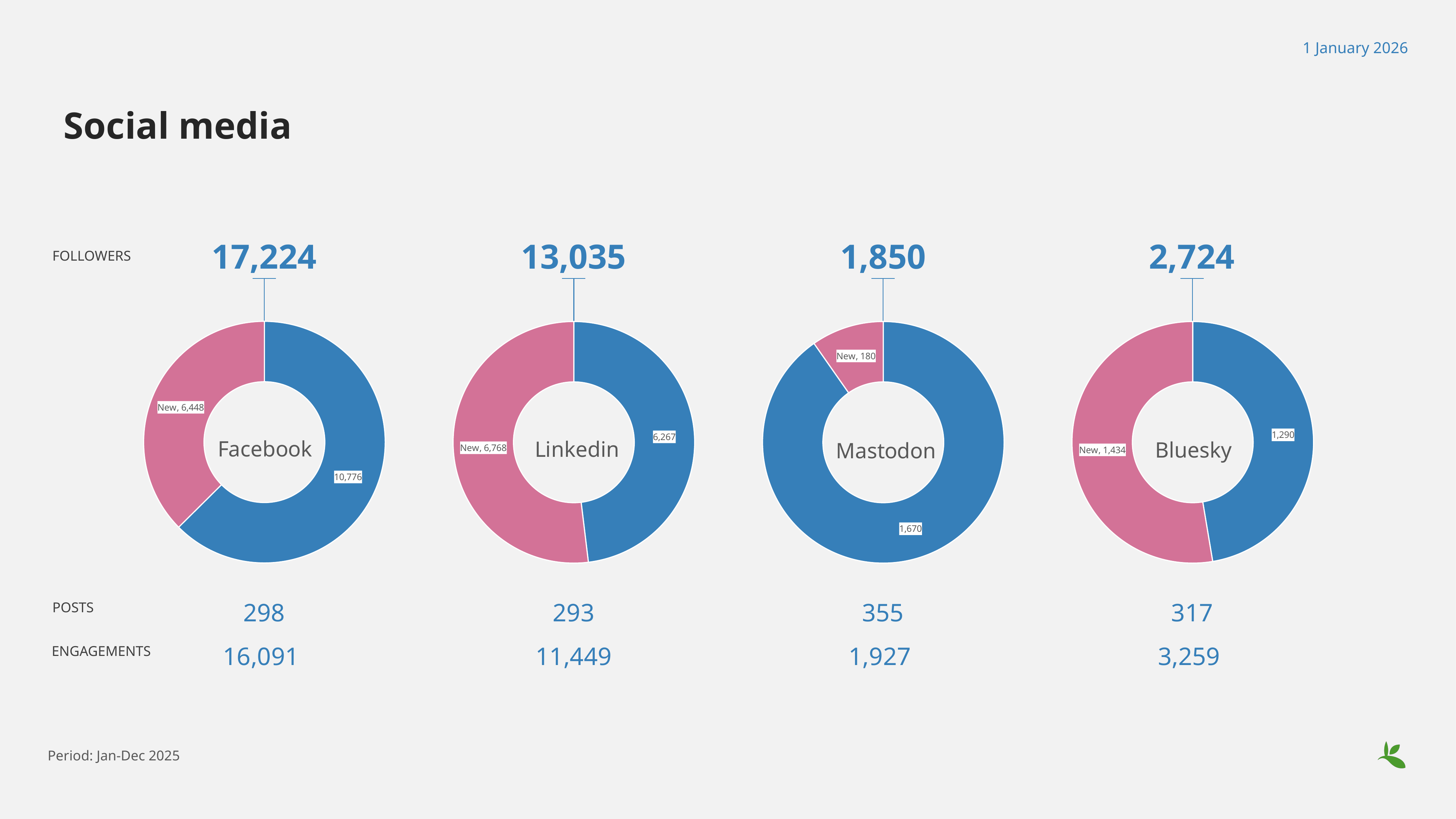
In the Facebook chart, what is the value of the New slice? 6,448 How many slices does the Mastodon chart have? 2 In the Bluesky chart, what is the value of the blue (existing followers) slice? 1,290 In the Linkedin chart, which slice is larger, New or the blue existing-followers slice? New In the Mastodon chart, which slice is smaller, New or the blue existing-followers slice? New What is the total number of followers shown above the Linkedin chart? 13,035 In the Mastodon chart, what is the value of the New slice? 180 In the Bluesky chart, what is the difference between the New slice (1,434) and the blue slice (1,290)? 144 In the Facebook chart, what is the difference between the blue slice (10,776) and the New slice (6,448)? 4,328 In the Linkedin chart, what is the value of the New slice? 6,768 What kind of chart is used for the Facebook chart? Donut (pie) chart In the Facebook chart, what is the value of the blue (existing followers) slice? 10,776